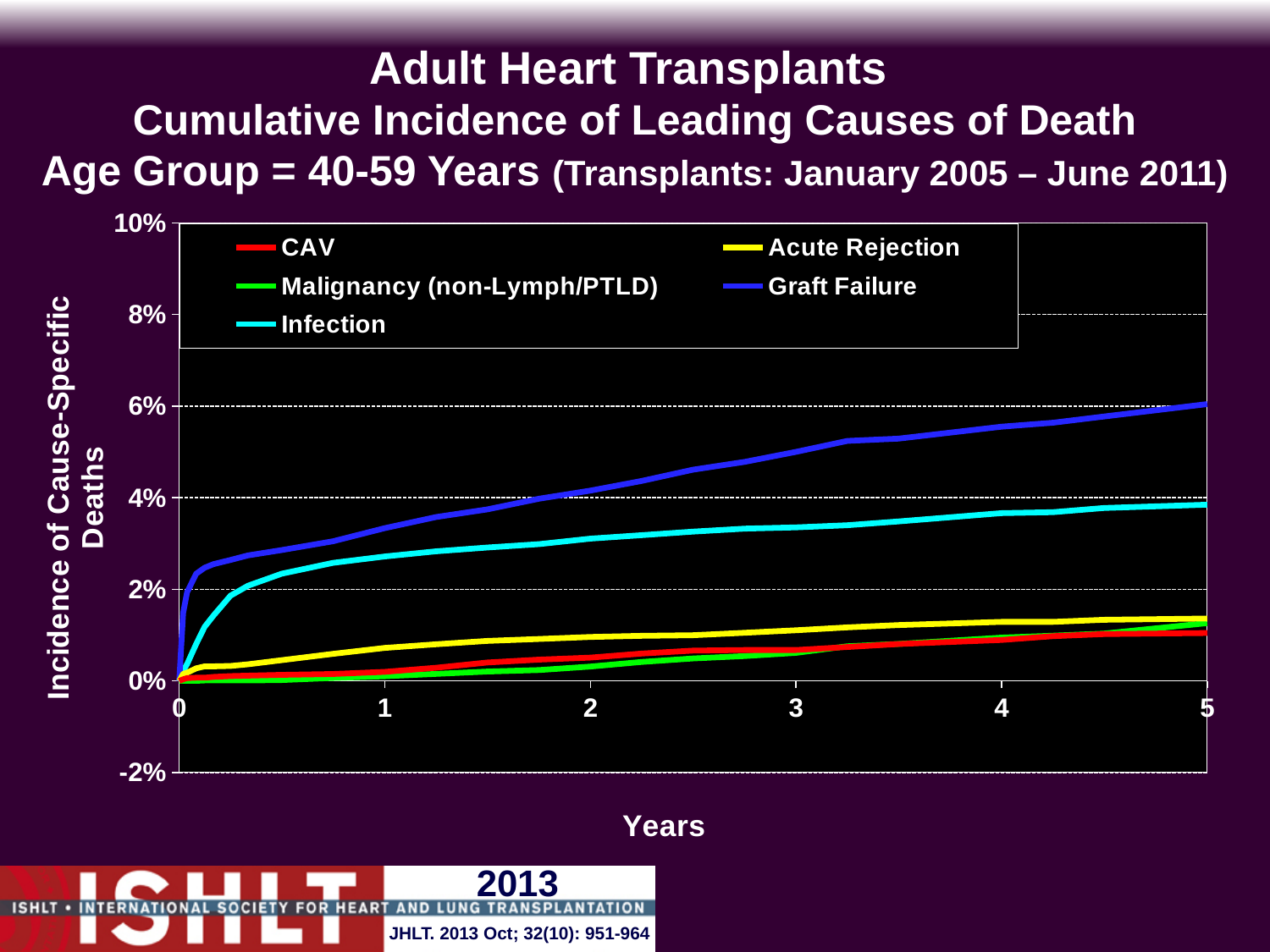
What is the label of the x axis? Years Is the value for Graft Failure at 5 years greater or less than 4%? greater Which cause of death has the highest cumulative incidence at 5 years? Graft Failure How many series does the legend list? 5 What kind of chart is shown on the slide? line chart Does the Graft Failure line rise or fall as years increase? rise Is the value for Infection at 1 year greater or less than 2%? greater At 3 years, which is larger: Graft Failure or Infection? Graft Failure What colour is the Graft Failure line in the legend? blue Is the value for Acute Rejection at 5 years greater or less than 2%? less Which cause of death has the second-highest cumulative incidence at 5 years? Infection